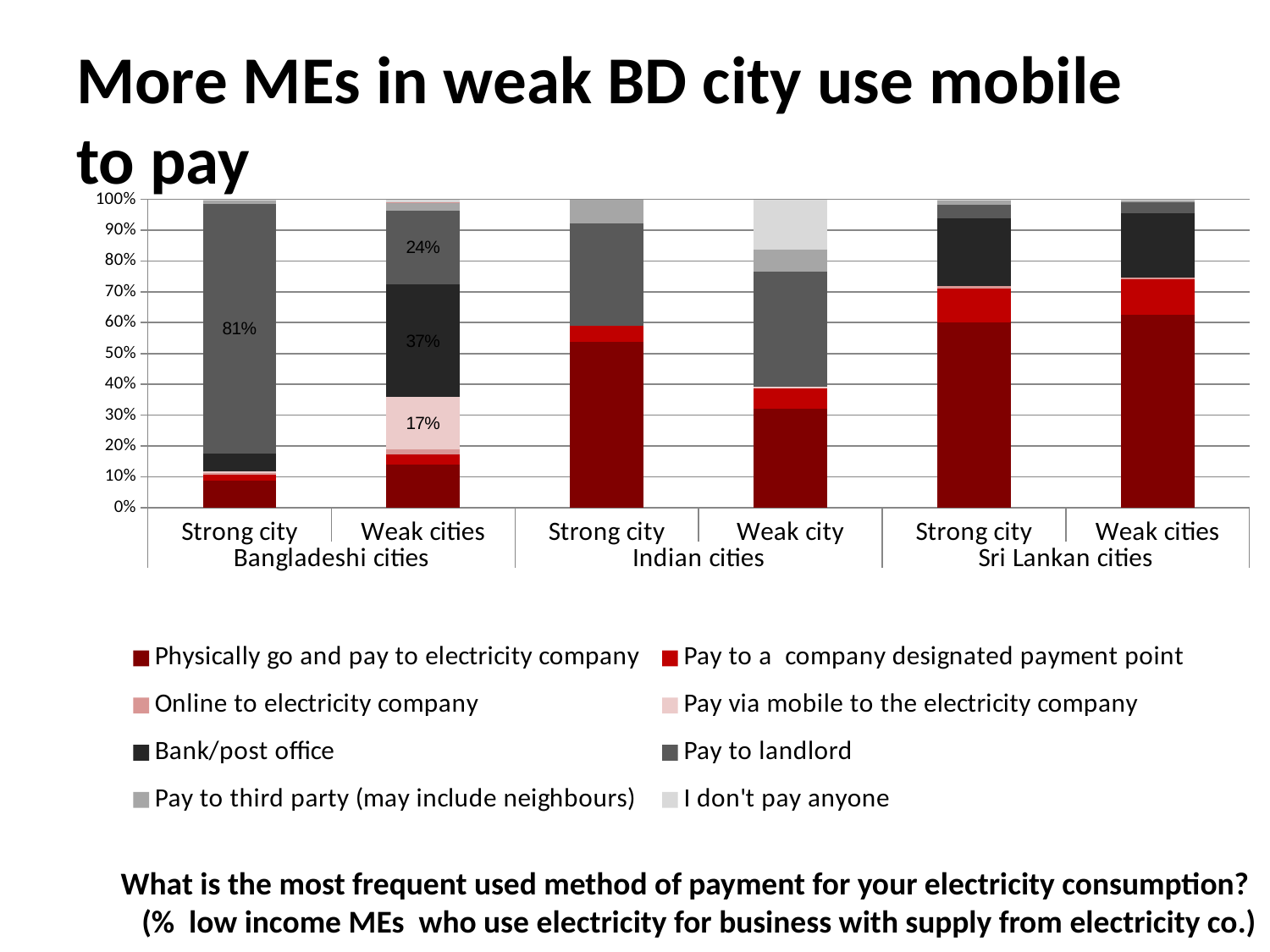
What percentage of MEs in the Bangladeshi Weak cities pay to landlord? 24% In the Bangladeshi Weak cities, which is larger: the Bank/post office share or the Pay to landlord share? Bank/post office What percentage of MEs in the Bangladeshi Weak cities use Bank/post office to pay? 37% How many percentage points higher is the 'Pay to landlord' share in the Bangladeshi Strong city than in the Bangladeshi Weak cities? 57 percentage points What percentage of MEs in the Bangladeshi Weak cities pay via mobile to the electricity company? 17% Is the 'Physically go and pay to electricity company' share for the Indian Strong city greater or less than 50%? greater What percentage of MEs in the Bangladeshi Strong city pay to landlord? 81% Which bar has a larger 'Physically go and pay to electricity company' share: the Sri Lankan Strong city or the Indian Weak city? Sri Lankan Strong city What kind of chart is shown on the slide? Stacked bar chart How many series does the legend list? 8 How many bars are plotted in the chart? 6 Which bar has the largest 'I don't pay anyone' segment? Indian Weak city